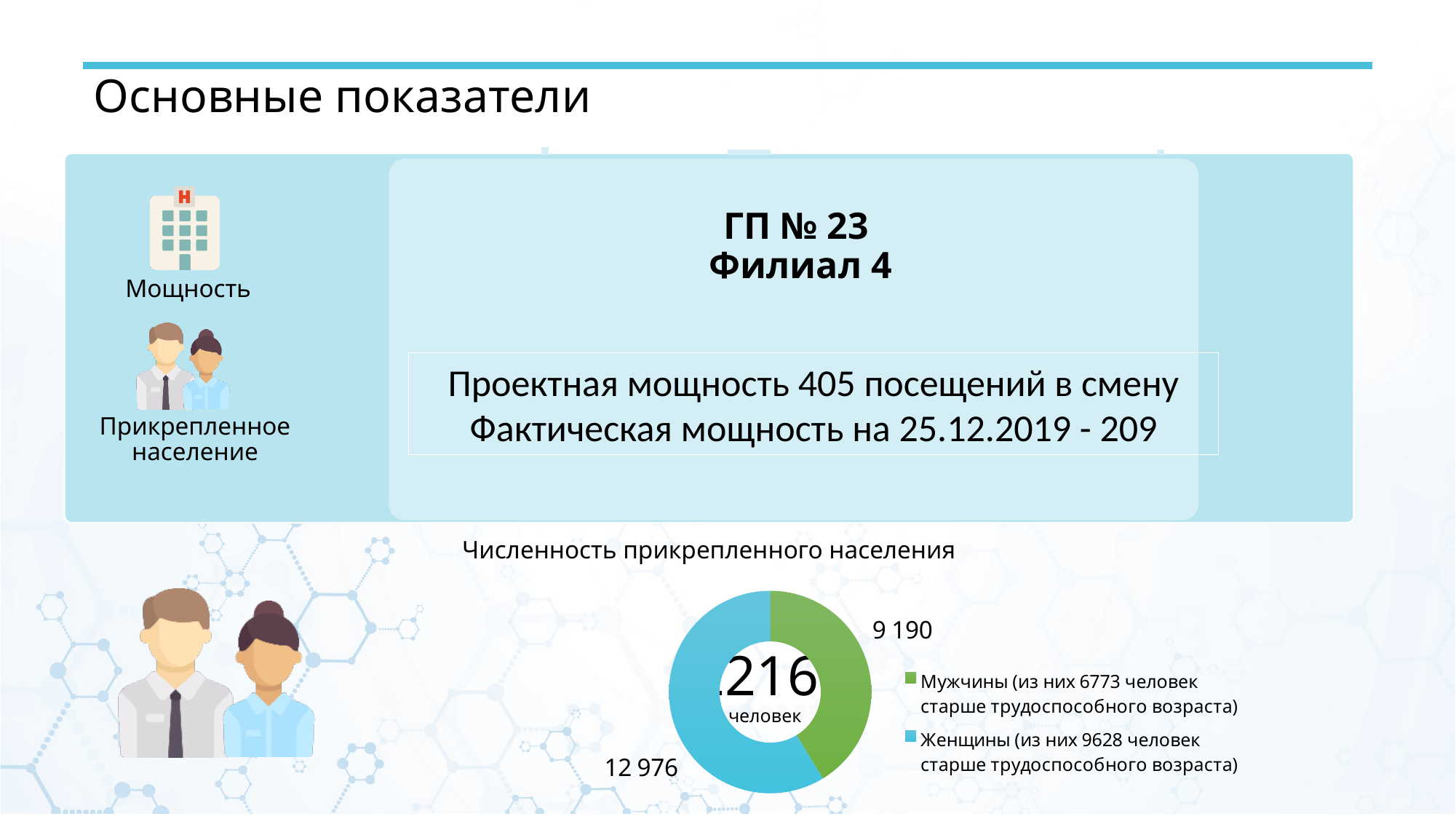
Which category has the largest slice in the pie chart? Женщины What is the sum of the two values shown on the pie chart? 22 166 Which category has the smallest slice in the pie chart? Мужчины What is the value shown for the "Мужчины" slice of the pie chart? 9 190 What is the difference between the "Женщины" and "Мужчины" values in the pie chart? 3 786 What is the title of the pie chart? Численность прикрепленного населения How many slices does the pie chart have? 2 Which slice of the pie chart is larger, "Мужчины" or "Женщины"? Женщины What is the value shown for the "Женщины" slice of the pie chart? 12 976 Which colour represents "Мужчины" in the pie chart? Green How many entries does the legend of the pie chart list? 2 What kind of chart is shown under the heading "Численность прикрепленного населения"? Pie chart (donut)